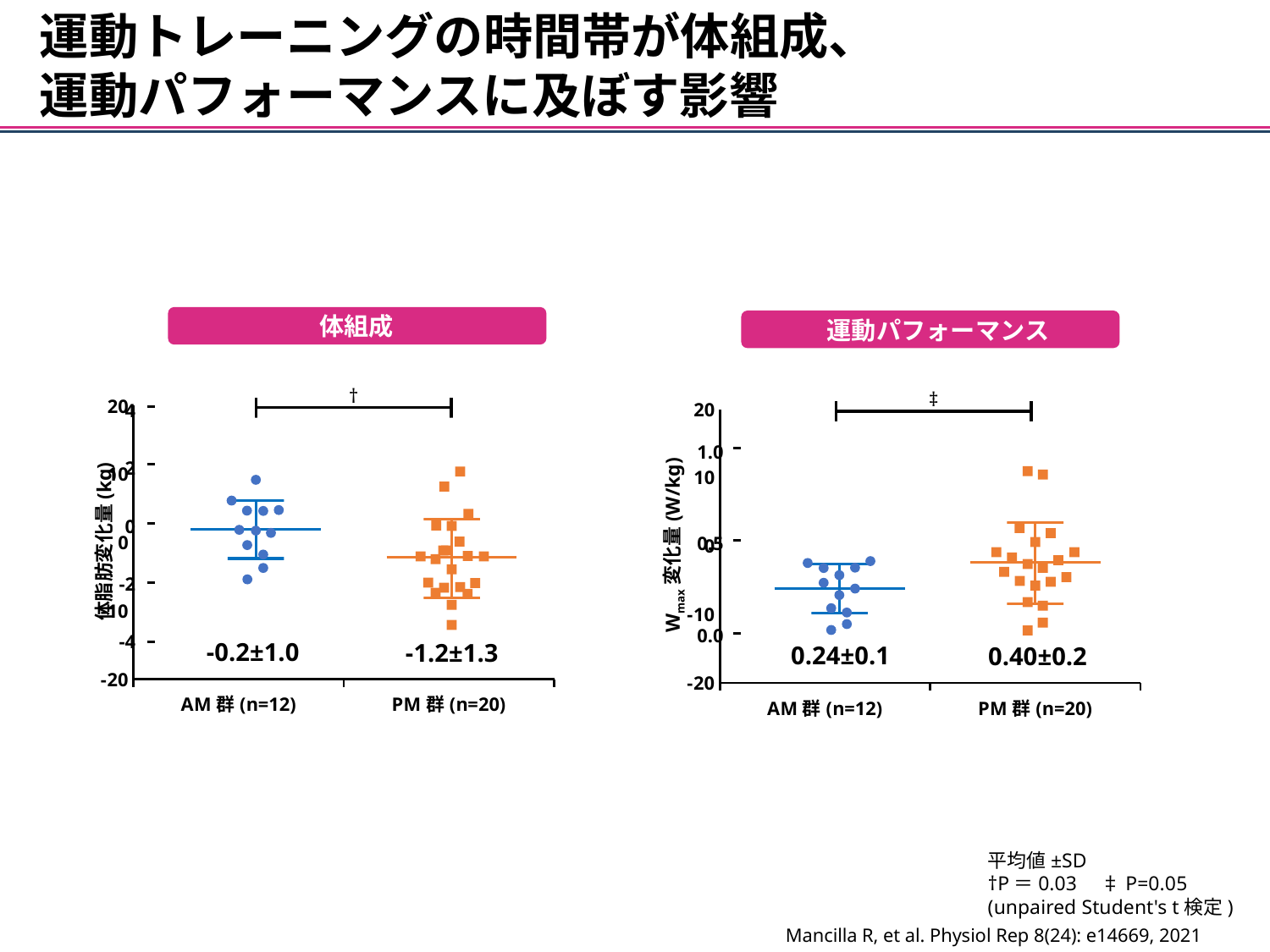
In the 運動パフォーマンス chart, what is the difference between the mean values of the PM 群 and AM 群 groups? 0.16 What is the y-axis label of the 体組成 chart? 体脂肪変化量 (kg) In the 体組成 chart, what is the mean ± SD value shown for the AM 群 (n=12) group? -0.2±1.0 In the 運動パフォーマンス chart, what is the mean ± SD value shown for the AM 群 (n=12) group? 0.24±0.1 How many groups are plotted on the x axis of the 体組成 chart? 2 In the 運動パフォーマンス chart, which group has the higher mean Wmax change, AM 群 or PM 群? PM 群 In the 体組成 chart, which group has the lower mean body fat change, AM 群 or PM 群? PM 群 In the 体組成 chart, what is the difference between the mean values of the AM 群 and PM 群 groups? 1.0 In the 運動パフォーマンス chart, what is the mean ± SD value shown for the PM 群 (n=20) group? 0.40±0.2 According to the footnote, what P value does the † symbol on the 体組成 chart indicate? P = 0.03 In the 体組成 chart, what is the mean ± SD value shown for the PM 群 (n=20) group? -1.2±1.3 What kind of chart is the 運動パフォーマンス chart? Scatter (dot) plot